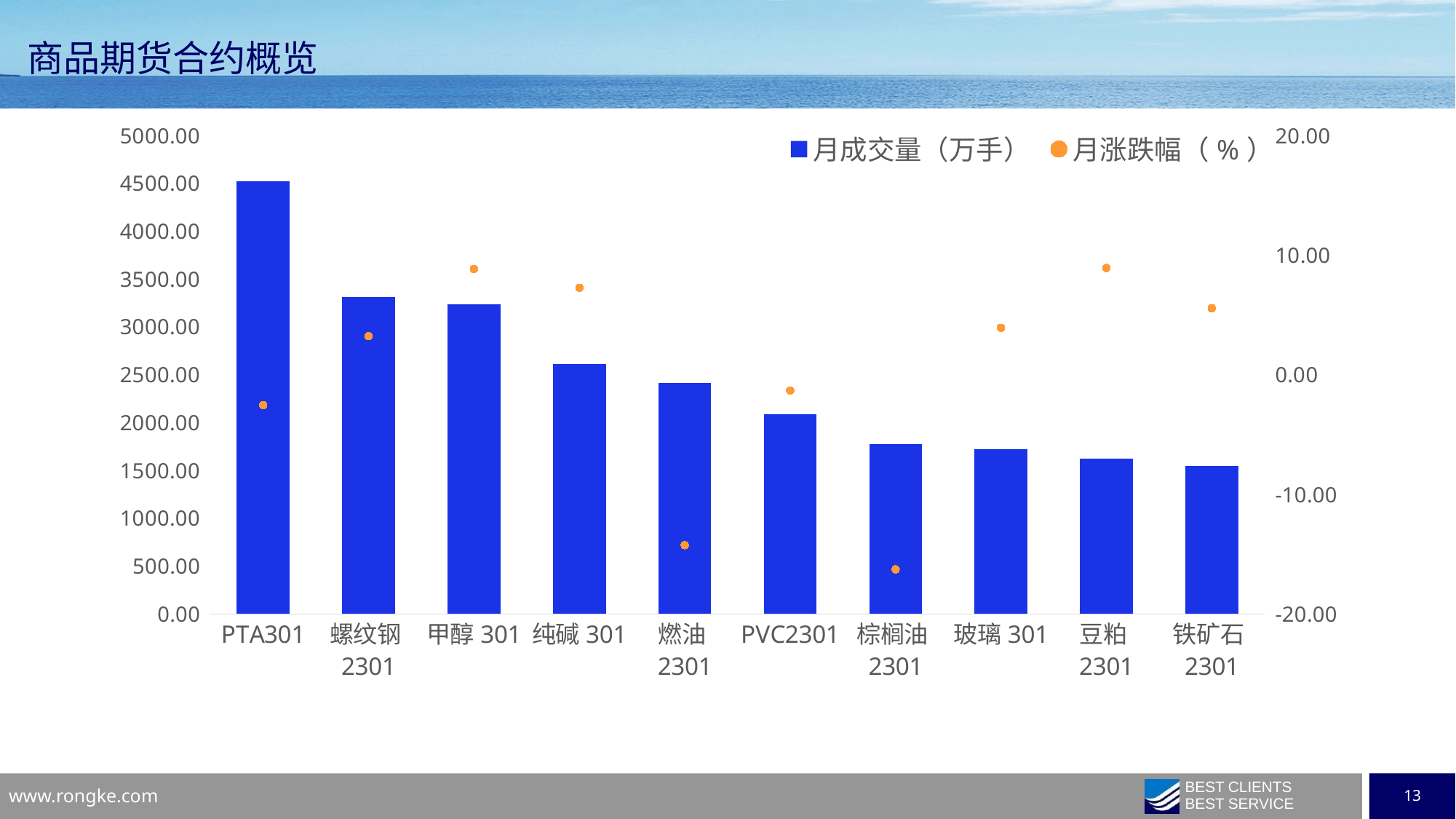
Which contract has the lowest 月成交量（万手）? 铁矿石2301 Which contract has the highest 月成交量（万手）? PTA301 Is the 月涨跌幅（%） for 棕榈油2301 greater or less than -10? less Is the 月成交量（万手） for PTA301 greater or less than 4000? greater How many contracts (categories) are shown on the x axis? 10 Is the 月成交量（万手） for 螺纹钢2301 greater or less than 3000? greater Which contract has the lowest 月涨跌幅（%）? 棕榈油2301 How many series does the legend list? 2 Which has the larger 月成交量（万手）, 甲醇301 or 纯碱301? 甲醇301 Do the 月成交量（万手） bars rise or fall from left to right along the x axis? fall What kind of chart is shown on the slide? A bar chart combined with a dot (scatter) series